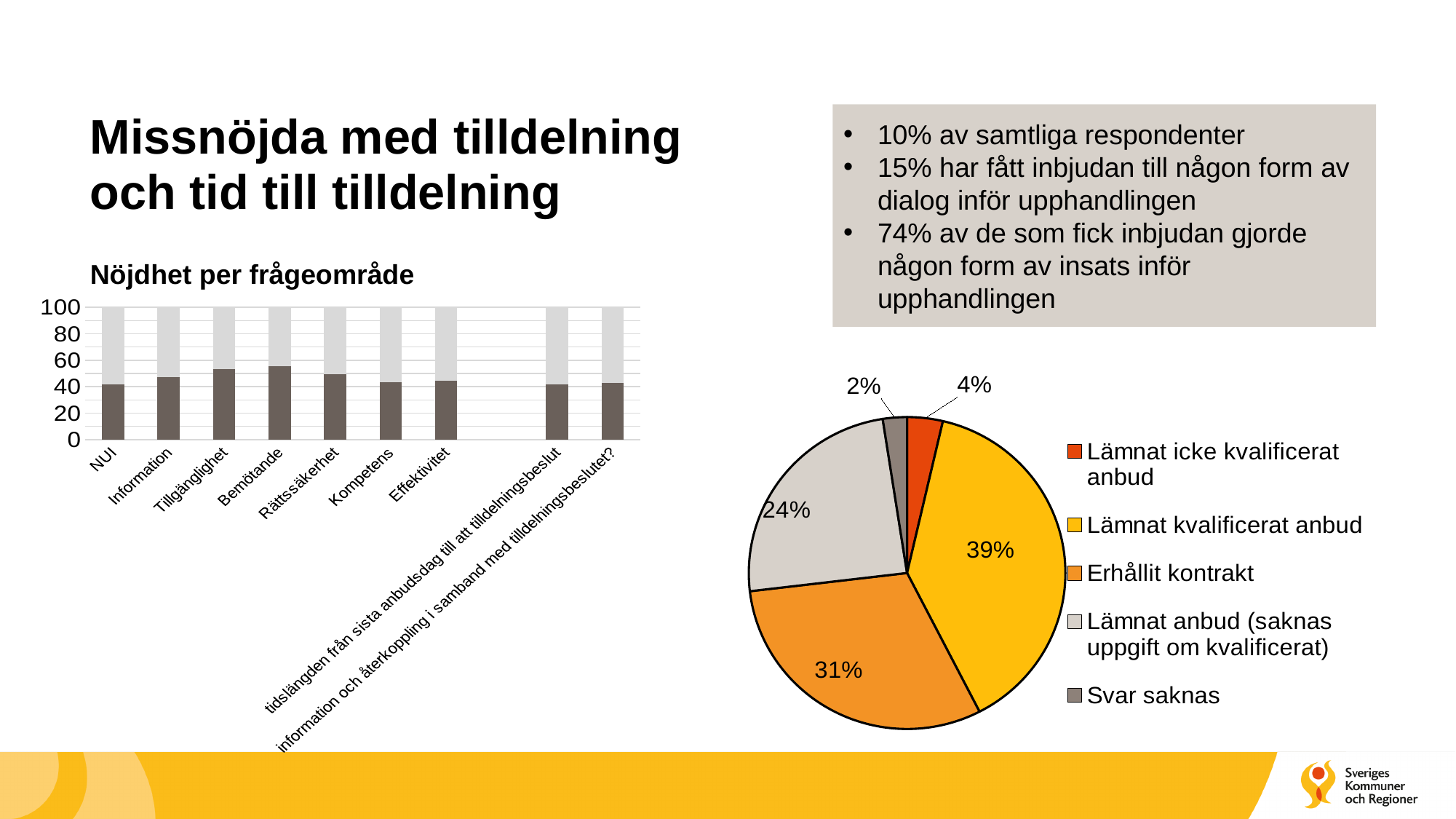
How many entries does the legend of the pie chart list? 5 In the pie chart, what share is labelled for Erhållit kontrakt? 31% In the pie chart, what is the difference in percentage points between Lämnat kvalificerat anbud and Erhållit kontrakt? 8 percentage points In the pie chart, what share is labelled for Svar saknas? 2% In the chart titled Nöjdhet per frågeområde, is the value for NUI greater or less than 60? less In the chart titled Nöjdhet per frågeområde, which is larger, the value for Bemötande or the value for Kompetens? Bemötande In the chart titled Nöjdhet per frågeområde, how many bars are plotted? 9 In the pie chart, which category has the largest slice? Lämnat kvalificerat anbud What kind of chart is the chart titled Nöjdhet per frågeområde? Bar chart In the pie chart, what share is labelled for Lämnat kvalificerat anbud? 39% In the pie chart, which category has the smallest slice? Svar saknas In the chart titled Nöjdhet per frågeområde, is the value for Bemötande greater or less than 40? greater